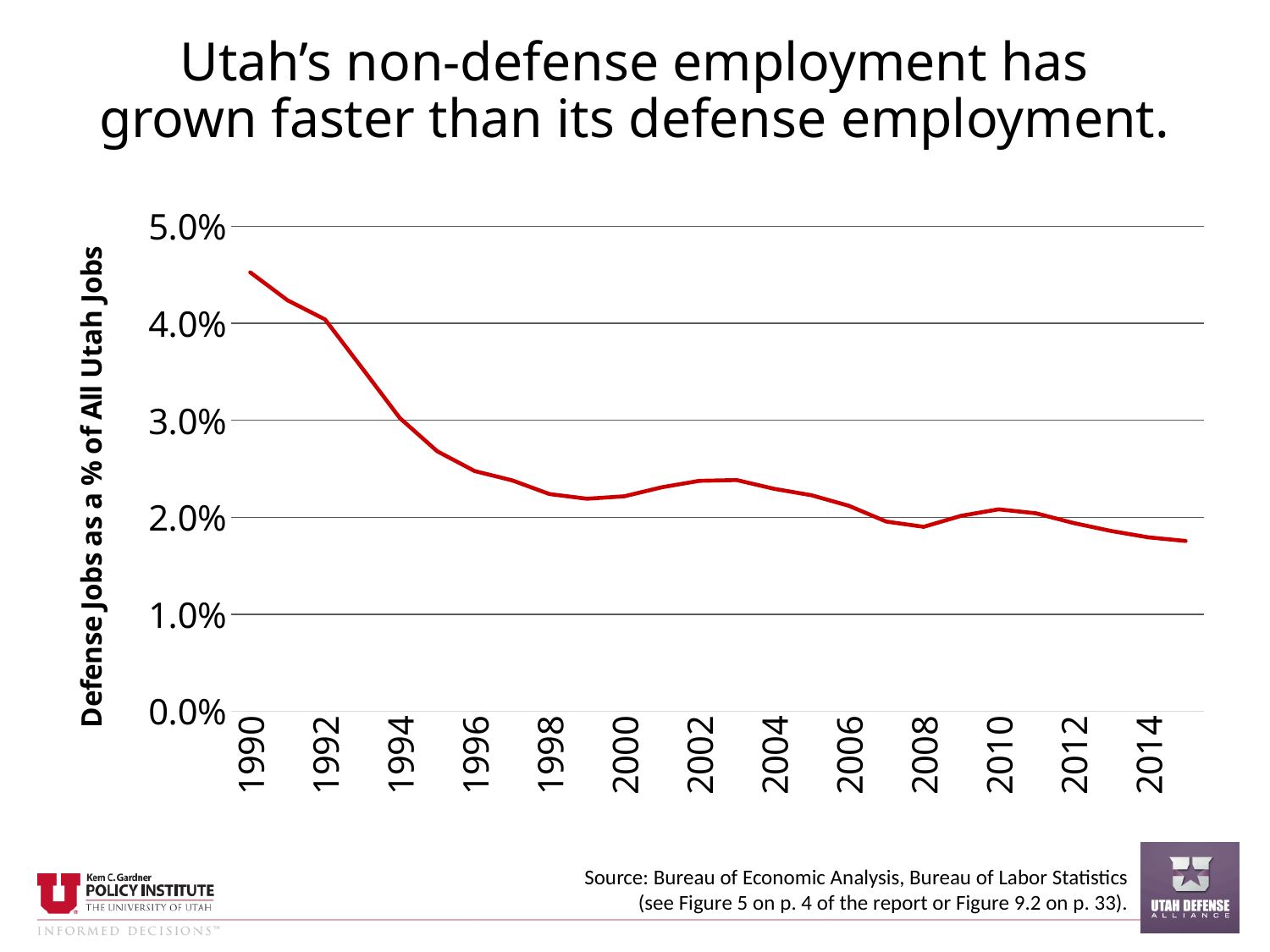
What kind of chart is shown on the slide? line chart Is the value for 1990 greater or less than 4.0%? greater How many year labels are shown on the x axis? 13 In which year is the value highest? 1990 Is the value for 2000 greater or less than 2.0%? greater Which year has the larger value, 1990 or 2014? 1990 Is the value for 2014 greater or less than 2.0%? less Overall, do the values rise or fall from 1990 to the end of the series? fall What is the title of the slide? Utah's non-defense employment has grown faster than its defense employment. Which year has the larger value, 2002 or 2006? 2002 What is the label on the vertical axis of the chart? Defense Jobs as a % of All Utah Jobs